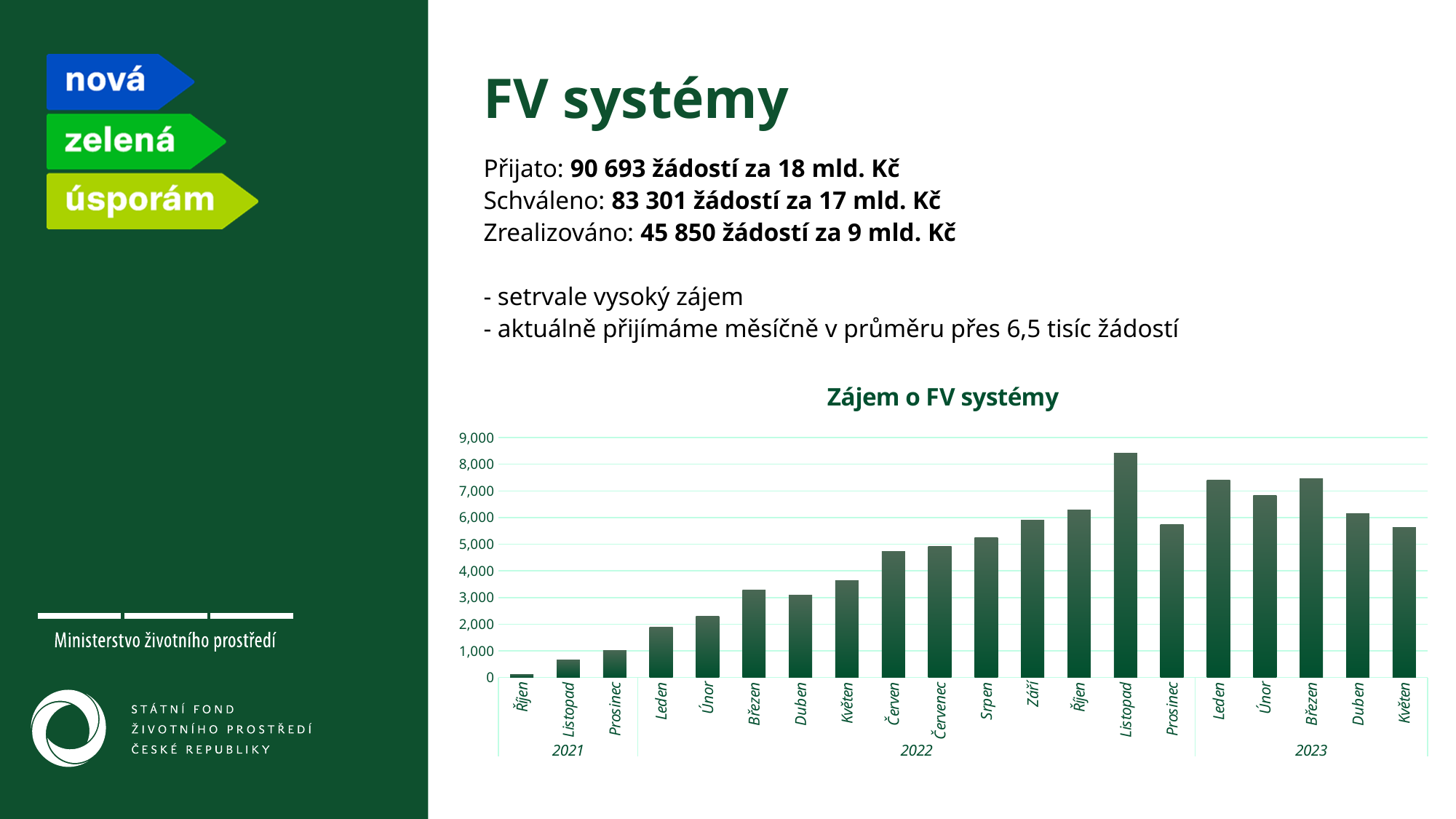
Is the value for Leden 2023 greater or less than 7,000? greater Which is larger, the value for Březen 2023 or the value for Duben 2023? Březen 2023 What is the title of the chart? Zájem o FV systémy Is the value for Říjen 2021 greater or less than 1,000? less Which month has the highest value in the chart? Listopad 2022 Is the value for Prosinec 2022 greater or less than 6,000? less Do the values generally rise or fall from Říjen 2021 to Listopad 2022? rise How many year groups are labelled on the x axis of the chart? 3 How many bars (months) are plotted in the chart? 20 Which month has the lowest value in the chart? Říjen 2021 What type of chart is shown on the slide? bar chart